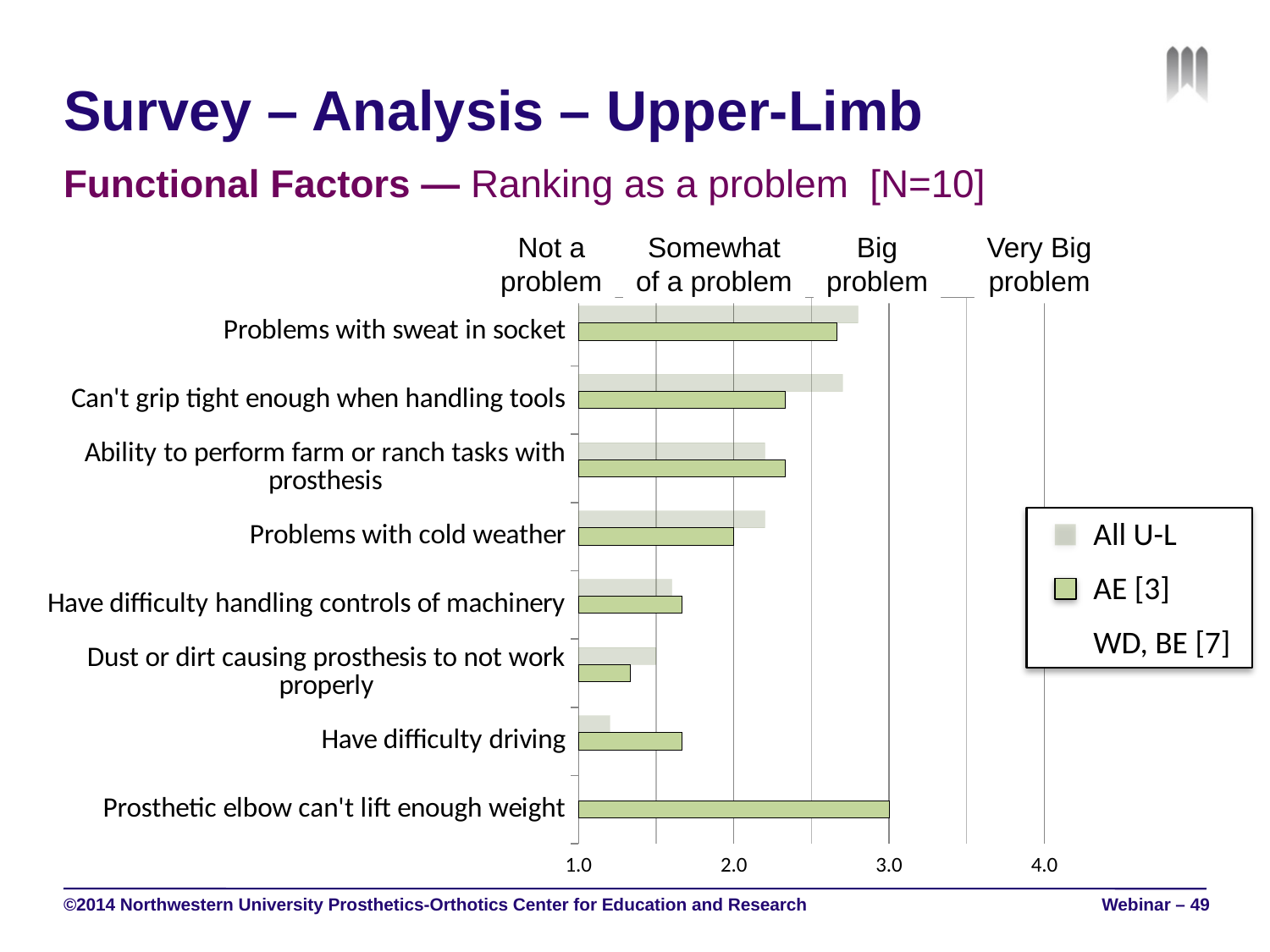
For 'Problems with cold weather', which series has the larger value, All U-L or AE [3]? All U-L What kind of chart is shown on the slide? bar chart Is the All U-L value for 'Have difficulty driving' greater or less than 2.0? less How many series does the chart legend list? 3 How many categories (functional factors) are listed on the chart? 8 For 'Have difficulty driving', which series has the larger value, All U-L or AE [3]? AE [3] What label is shown above the 3.0 tick on the horizontal axis? Big problem Is the AE [3] value for 'Prosthetic elbow can't lift enough weight' greater or less than 2.0? greater Which category has the highest AE [3] value? Prosthetic elbow can't lift enough weight Is the All U-L value for 'Problems with sweat in socket' greater or less than 2.0? greater